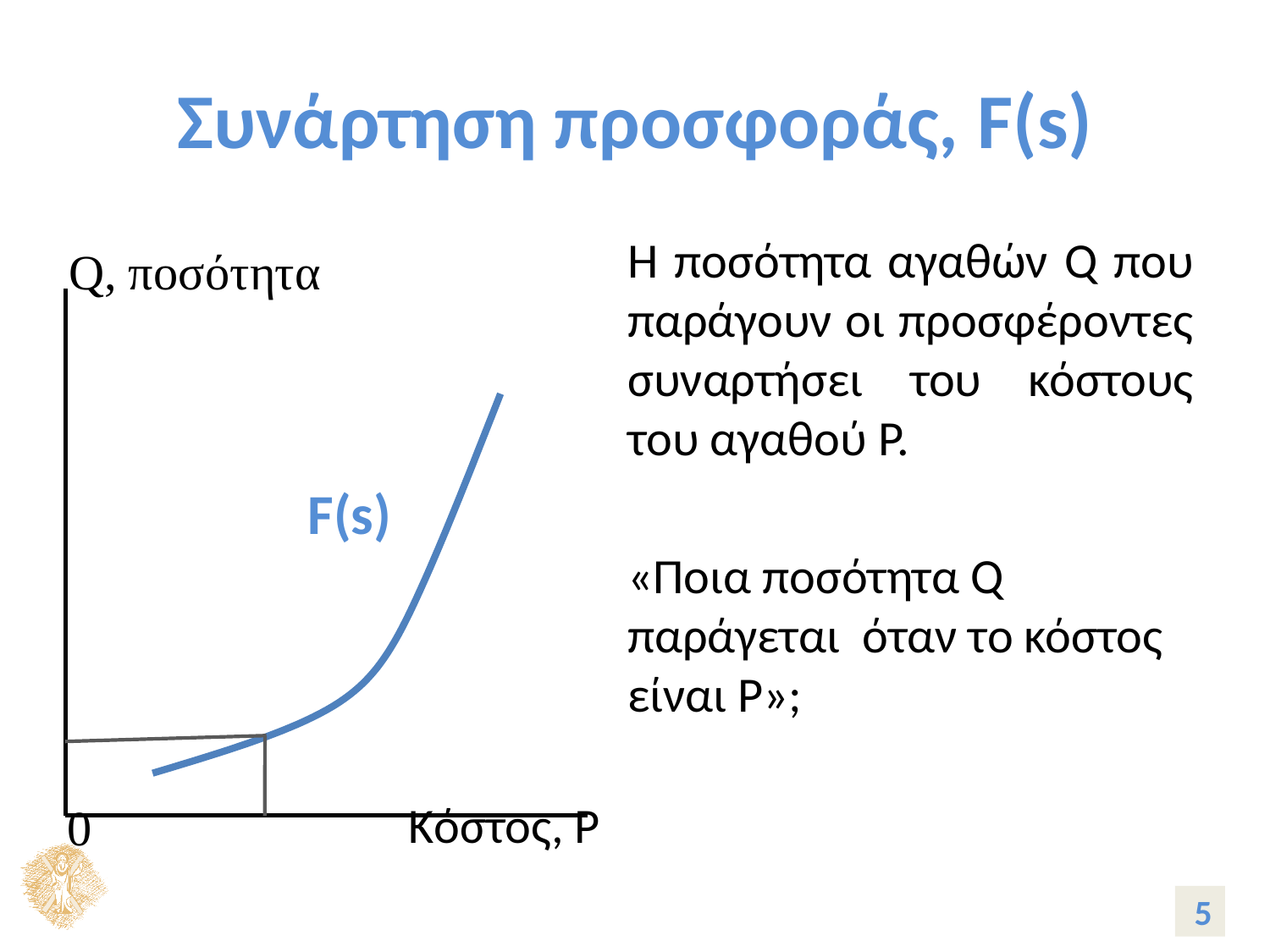
Does the curve F(s) rise or fall as cost P increases along the x axis? rises What kind of chart is shown on the slide? line chart How many curves are plotted on the chart? 1 What is the label of the horizontal axis of the chart? Κόστος, P What is the label of the curve plotted on the chart? F(s)